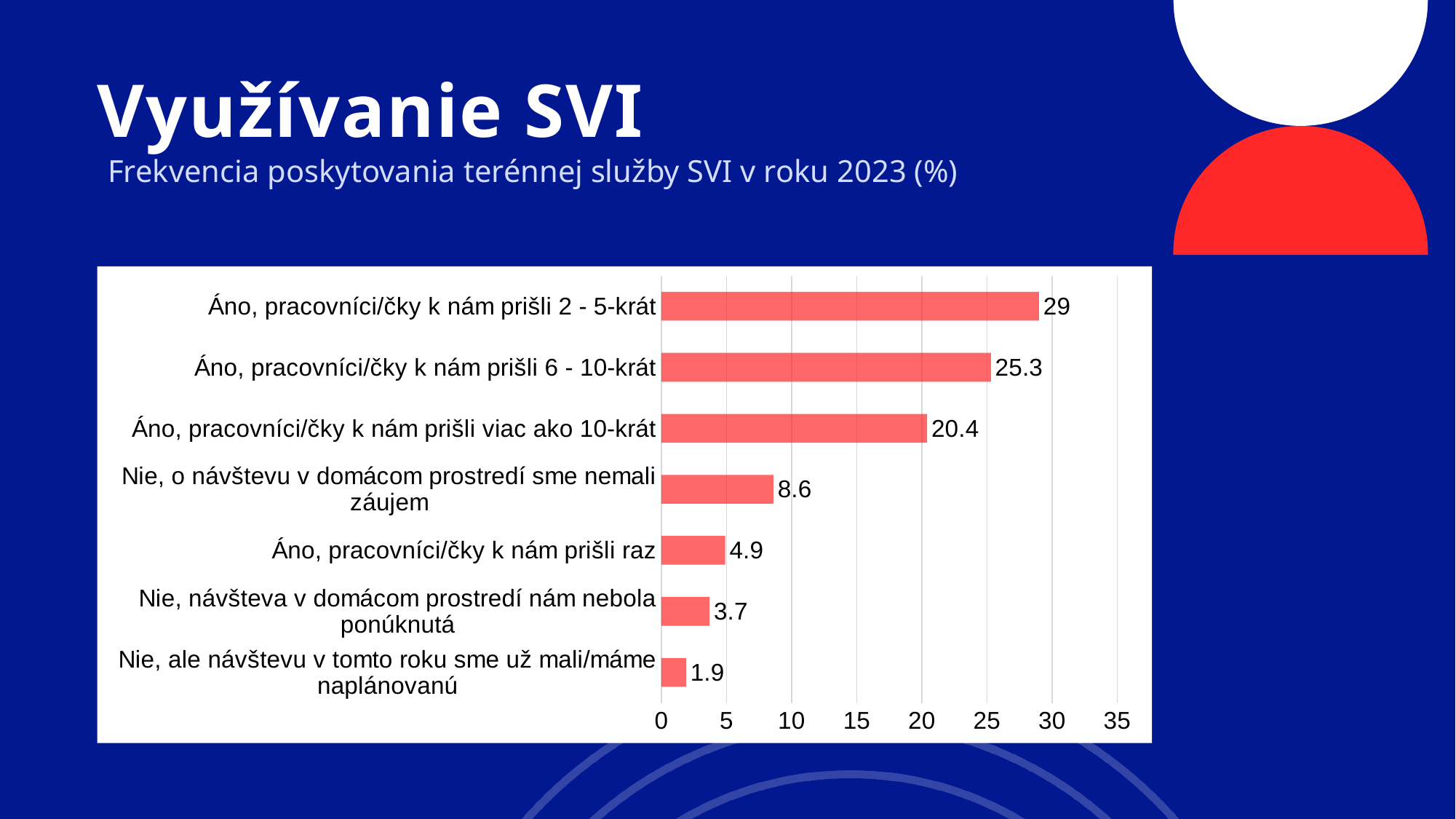
What is the value for "Áno, pracovníci/čky k nám prišli 2 - 5-krát"? 29 What is the value for "Nie, o návštevu v domácom prostredí sme nemali záujem"? 8.6 What kind of chart is shown on the slide? bar chart Which is larger: the value for "Áno, pracovníci/čky k nám prišli raz" or for "Nie, návšteva v domácom prostredí nám nebola ponúknutá"? Áno, pracovníci/čky k nám prišli raz Which category has the lowest value? Nie, ale návštevu v tomto roku sme už mali/máme naplánovanú Which category has the highest value? Áno, pracovníci/čky k nám prišli 2 - 5-krát What is the value for "Nie, ale návštevu v tomto roku sme už mali/máme naplánovanú"? 1.9 How many categories are shown in the chart? 7 Is the value for "Áno, pracovníci/čky k nám prišli viac ako 10-krát" greater or less than 20? greater What is the difference between the values for "Áno, pracovníci/čky k nám prišli 2 - 5-krát" and "Áno, pracovníci/čky k nám prišli 6 - 10-krát"? 3.7 What is the value for "Áno, pracovníci/čky k nám prišli 6 - 10-krát"? 25.3 What is the subtitle describing the chart on the slide? Frekvencia poskytovania terénnej služby SVI v roku 2023 (%)